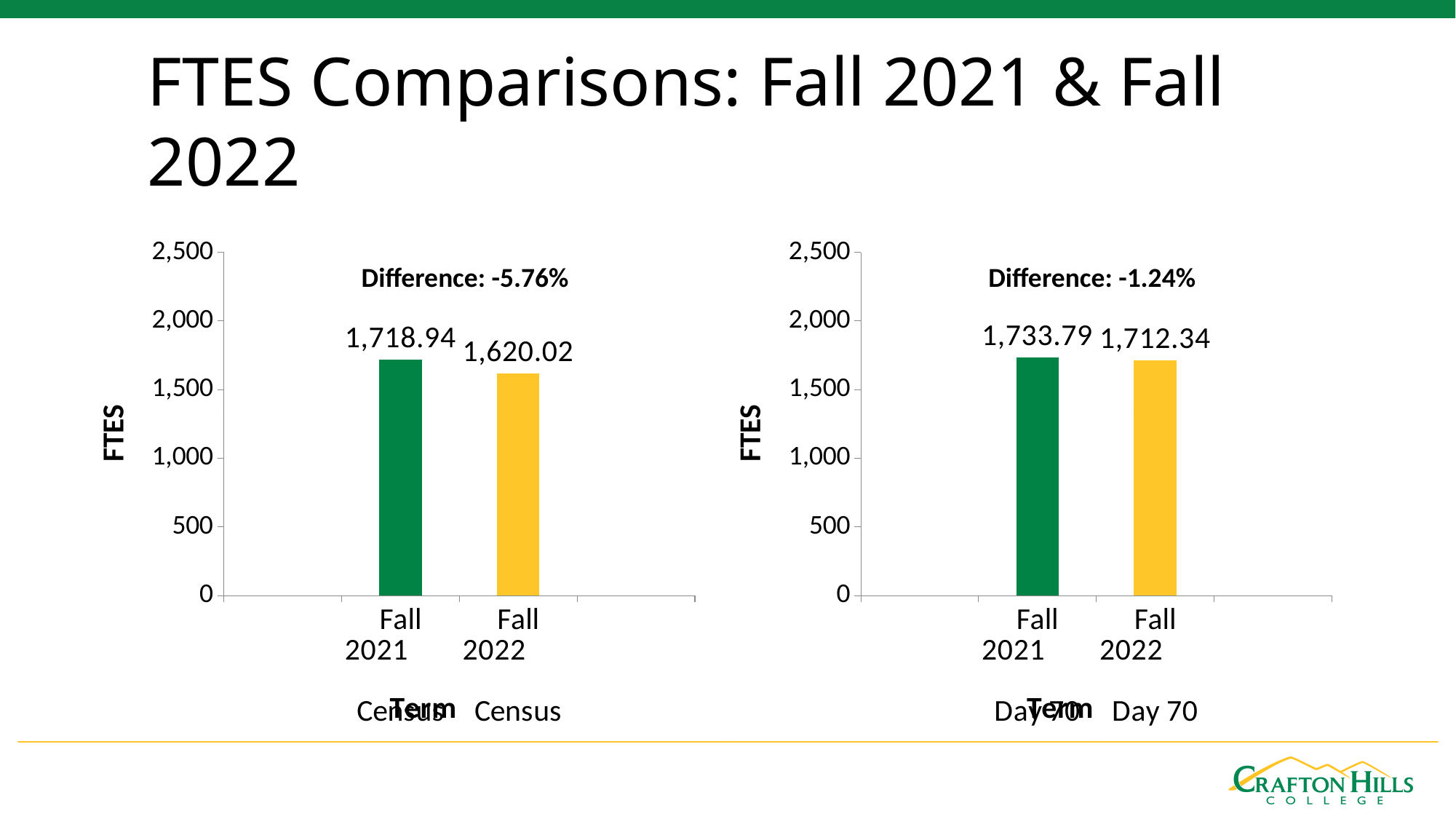
In the right chart (Day 70), what is the FTES value for Fall 2022? 1,712.34 What kind of chart is the right chart (Day 70)? bar chart In the left chart (Census), is the FTES value for Fall 2022 greater or less than 2,000? less In the left chart (Census), which term has the higher FTES? Fall 2021 In the left chart (Census), what is the FTES value for Fall 2022? 1,620.02 In the right chart (Day 70), what is the difference in FTES between Fall 2021 and Fall 2022? 21.45 In the left chart (Census), what is the difference in FTES between Fall 2021 and Fall 2022? 98.92 In the left chart (Census), what is the FTES value for Fall 2021? 1,718.94 How many bars are shown in the left chart (Census)? 2 In the right chart (Day 70), what is the FTES value for Fall 2021? 1,733.79 In the right chart (Day 70), which term has the lower FTES? Fall 2022 What percentage difference is annotated on the right chart (Day 70)? -1.24%